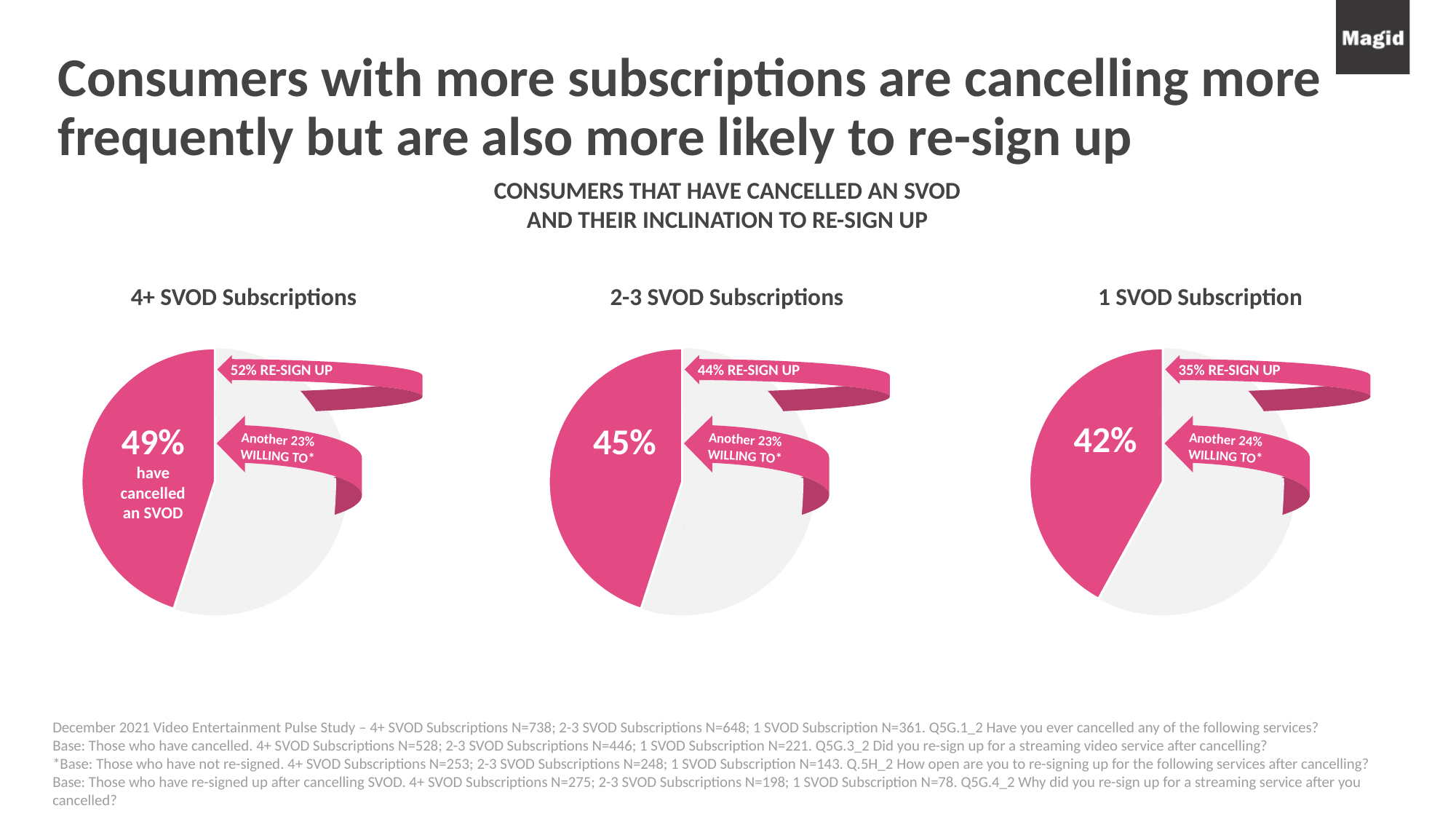
In the 1 SVOD Subscription chart, what percentage re-signed up? 35% What type of chart is used to show the share of consumers that have cancelled an SVOD? Pie chart Is the cancelled percentage higher in the 2-3 SVOD Subscriptions chart or the 1 SVOD Subscription chart? 2-3 SVOD Subscriptions What is the difference between the re-sign up percentage in the 4+ SVOD Subscriptions chart and the 1 SVOD Subscription chart? 17% In the 4+ SVOD Subscriptions chart, what percentage have cancelled an SVOD? 49% In the 1 SVOD Subscription chart, what percentage have cancelled an SVOD? 42% How many pie charts are shown on the slide? 3 In the 4+ SVOD Subscriptions chart, what percentage re-signed up? 52% Which of the three charts shows the lowest re-sign up percentage? 1 SVOD Subscription Which of the three charts shows the highest percentage that have cancelled an SVOD? 4+ SVOD Subscriptions In the 1 SVOD Subscription chart, what percentage are willing to re-sign up? 24% In the 2-3 SVOD Subscriptions chart, what percentage have cancelled an SVOD? 45%